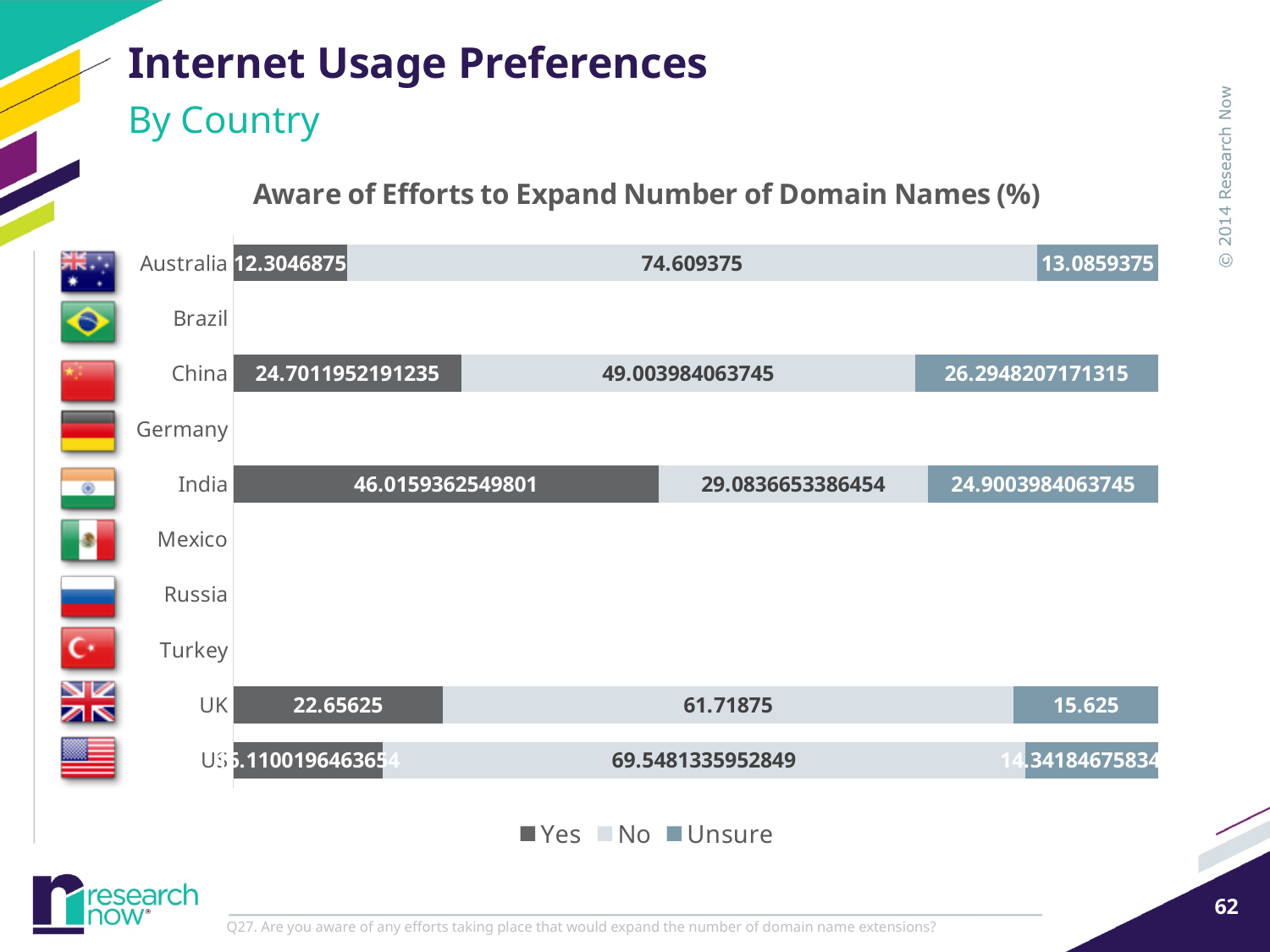
How many series does the legend list? 3 Which country has the highest 'Yes' value? India What is the 'No' value for Australia? 74.609375 Which has the larger 'No' value, the UK or China? UK What kind of chart is shown on the slide? Stacked bar chart What is the 'Yes' value for the UK? 22.65625 What is the 'Unsure' value for China? 26.2948207171315 What is the 'Yes' value for India? 46.0159362549801 What is the difference between the UK's 'No' value and its 'Yes' value? 39.0625 How many countries are listed on the chart's axis? 10 What are the legend entries of the chart? Yes, No, Unsure Which country has the highest 'No' value? Australia